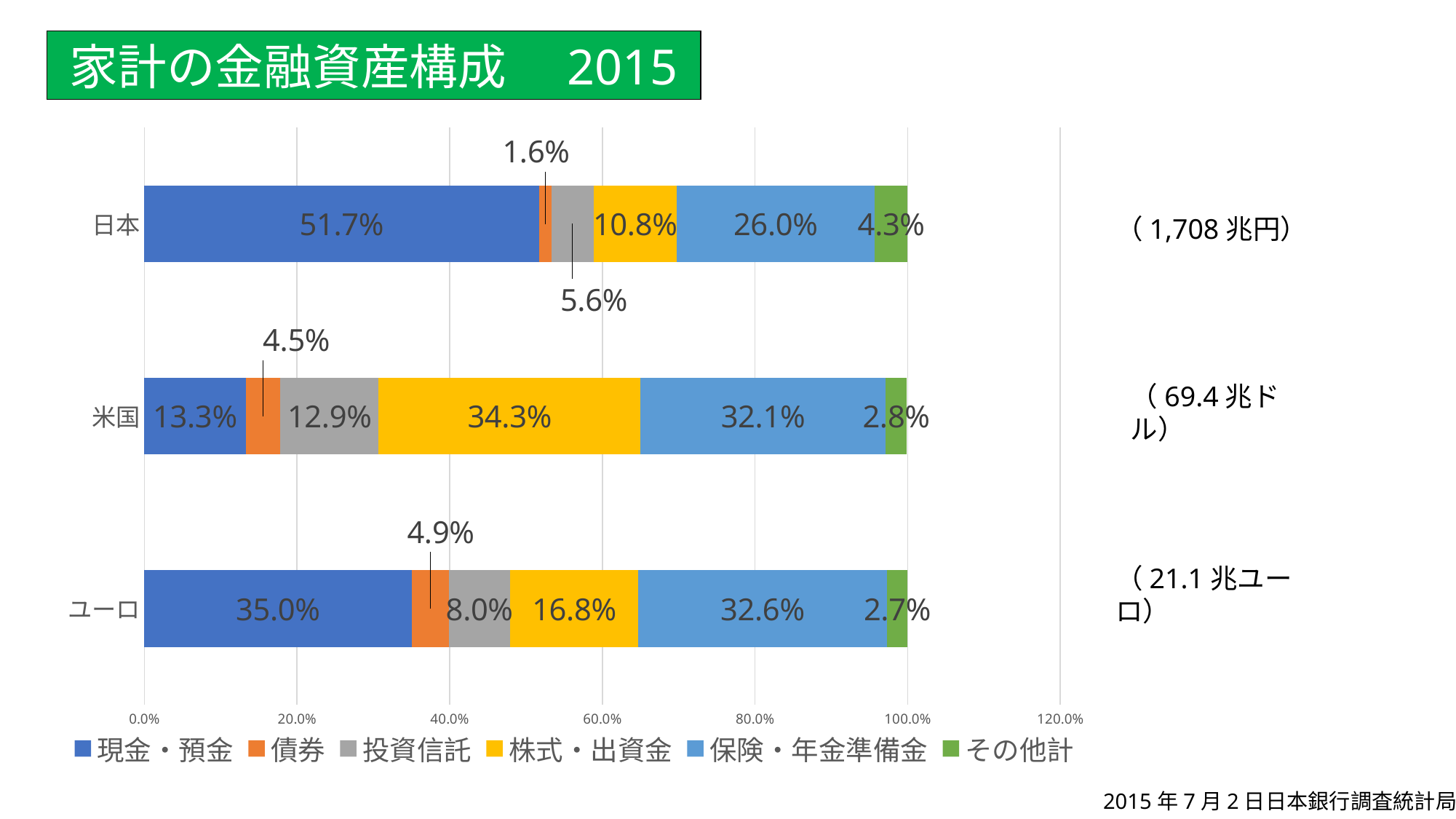
Which region has the highest share of 現金・預金? 日本 How many series does the legend list? 6 What is the share of 債券 for 日本? 1.6% What is the title of the chart on the slide? 家計の金融資産構成 2015 What kind of chart is shown on the slide? Stacked bar chart How many categories (regions) are plotted on the chart? 3 What is the share of 現金・預金 for 日本? 51.7% Which region has the lowest share of 株式・出資金? 日本 What is the difference between the 現金・預金 share of 日本 and that of 米国? 38.4% Which is larger: the 投資信託 share of 米国 or the 投資信託 share of ユーロ? 米国 What is the share of 保険・年金準備金 for ユーロ? 32.6% What is the share of 株式・出資金 for 米国? 34.3%